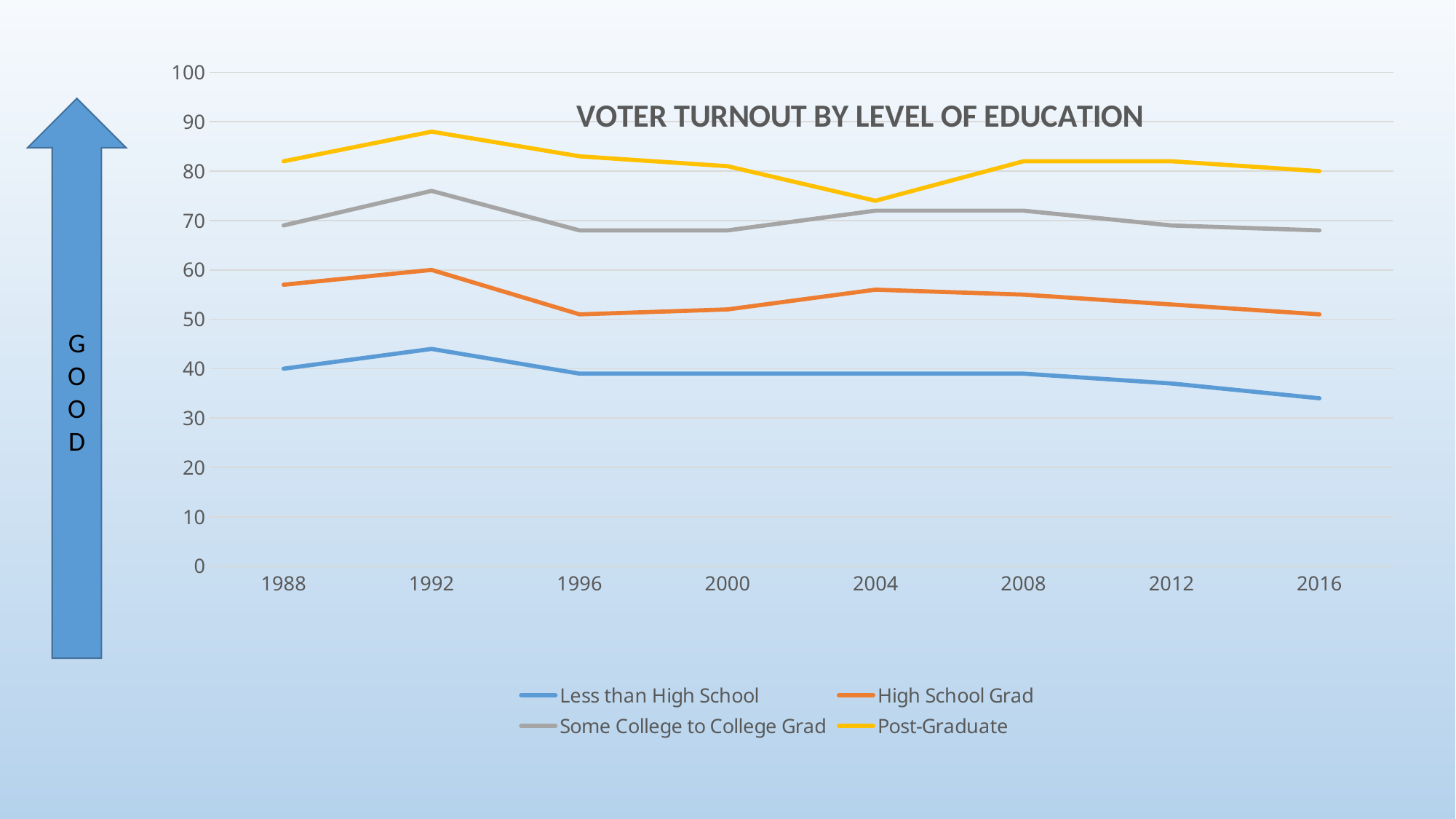
What kind of chart is shown on the slide? line chart Is the value for Post-Graduate in 2004 greater or less than 80? less Which education level has the lowest voter turnout across all years? Less than High School Is the value for Post-Graduate in 1992 greater or less than 80? greater In which year does the Post-Graduate line reach its highest value? 1992 How many series does the legend list? 4 Which education level has the highest voter turnout across all years? Post-Graduate What is the title of the chart? VOTER TURNOUT BY LEVEL OF EDUCATION Is the value for Less than High School in 2016 greater or less than 40? less Does the Less than High School line rise or fall from 2008 to 2016? fall How many years are plotted along the x axis? 8 In which year does the Less than High School line reach its lowest value? 2016